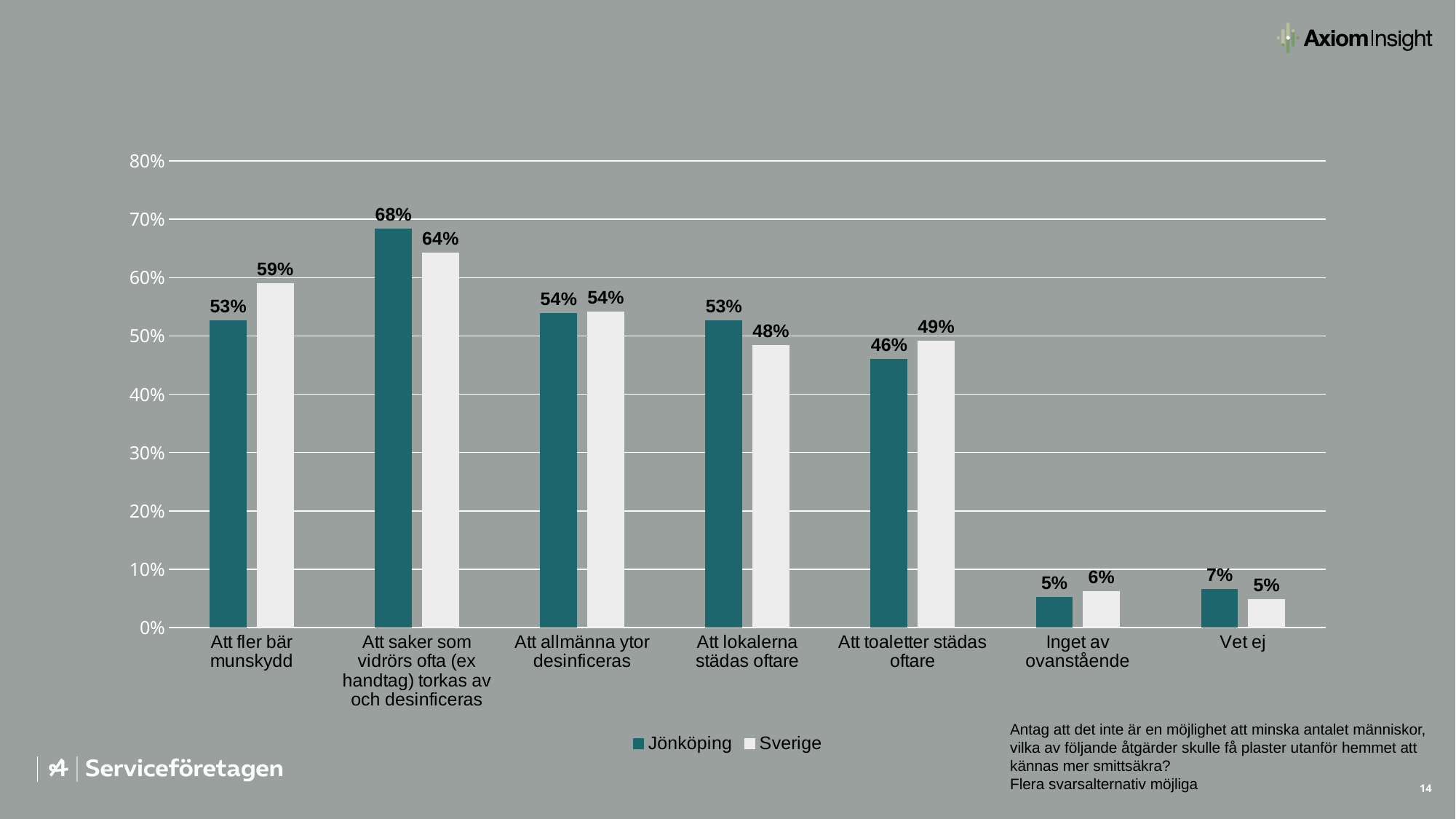
How many series does the legend list? 2 What is the Sverige value for 'Att fler bär munskydd'? 59% How many categories are shown on the x axis? 7 Which category has the highest Jönköping value? Att saker som vidrörs ofta (ex handtag) torkas av och desinficeras Which category has the lowest Sverige value? Vet ej What is the Jönköping value for 'Att saker som vidrörs ofta (ex handtag) torkas av och desinficeras'? 68% What is the Sverige value for 'Att lokalerna städas oftare'? 48% Which series is shown in the dark teal colour? Jönköping Is the Jönköping value for 'Att lokalerna städas oftare' greater or less than 50%? greater What kind of chart is shown on the slide? Bar chart Which is larger for 'Att toaletter städas oftare', the Jönköping value or the Sverige value? Sverige What is the difference between the Jönköping and Sverige values for 'Att fler bär munskydd'? 6%